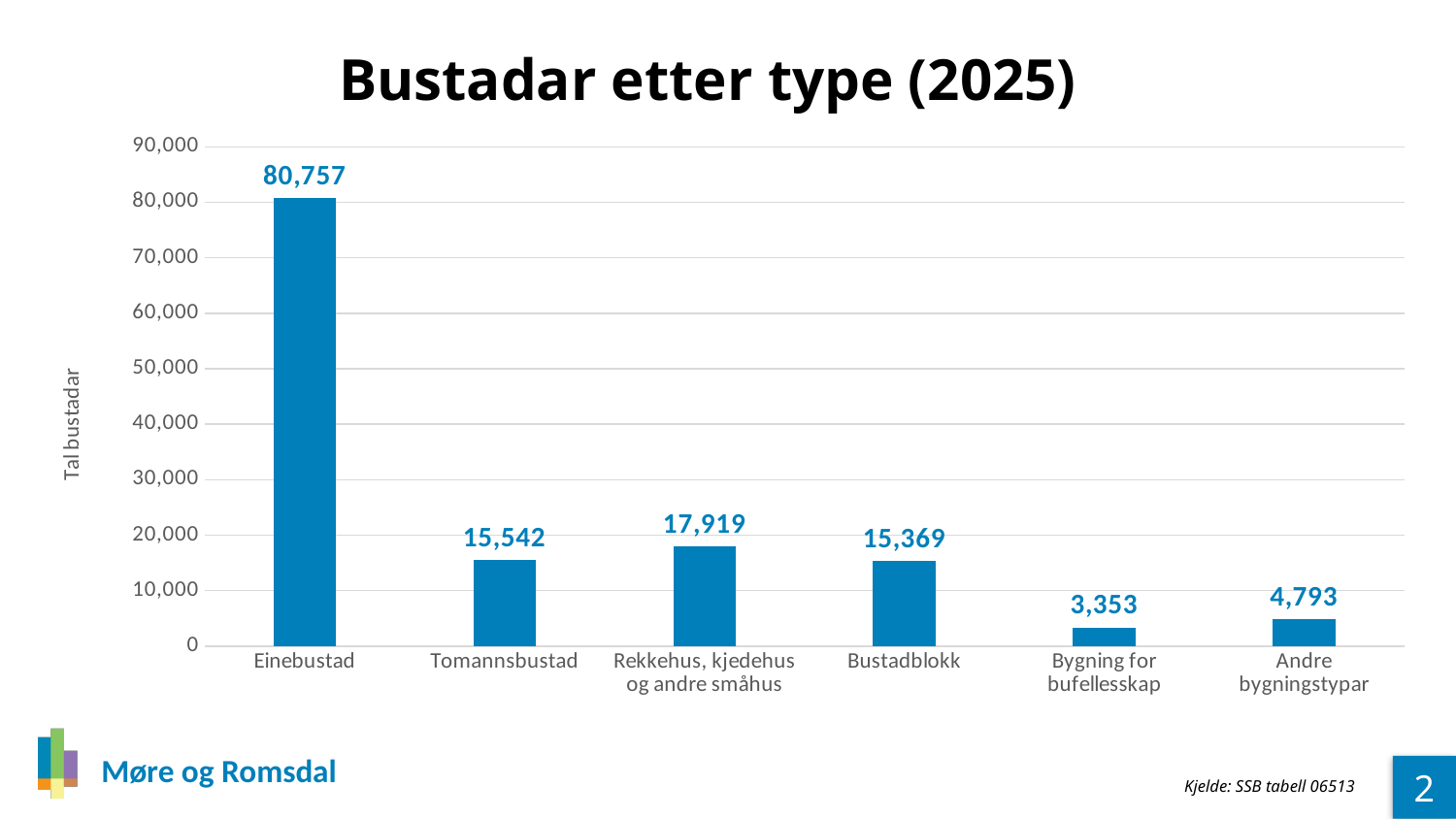
What is the value for Tomannsbustad? 15,542 What is the difference between the values for Einebustad and Bustadblokk? 65,388 Which category has the lowest value? Bygning for bufellesskap What is the value for Einebustad? 80,757 Which is larger, the value for Rekkehus, kjedehus og andre småhus or the value for Tomannsbustad? Rekkehus, kjedehus og andre småhus How many categories are shown on the x axis? 6 What is the value for Bygning for bufellesskap? 3,353 Is the value for Andre bygningstypar greater or less than 10,000? less What is the title of the chart? Bustadar etter type (2025) What kind of chart is this? bar chart What is the value for Rekkehus, kjedehus og andre småhus? 17,919 Which category has the highest value? Einebustad